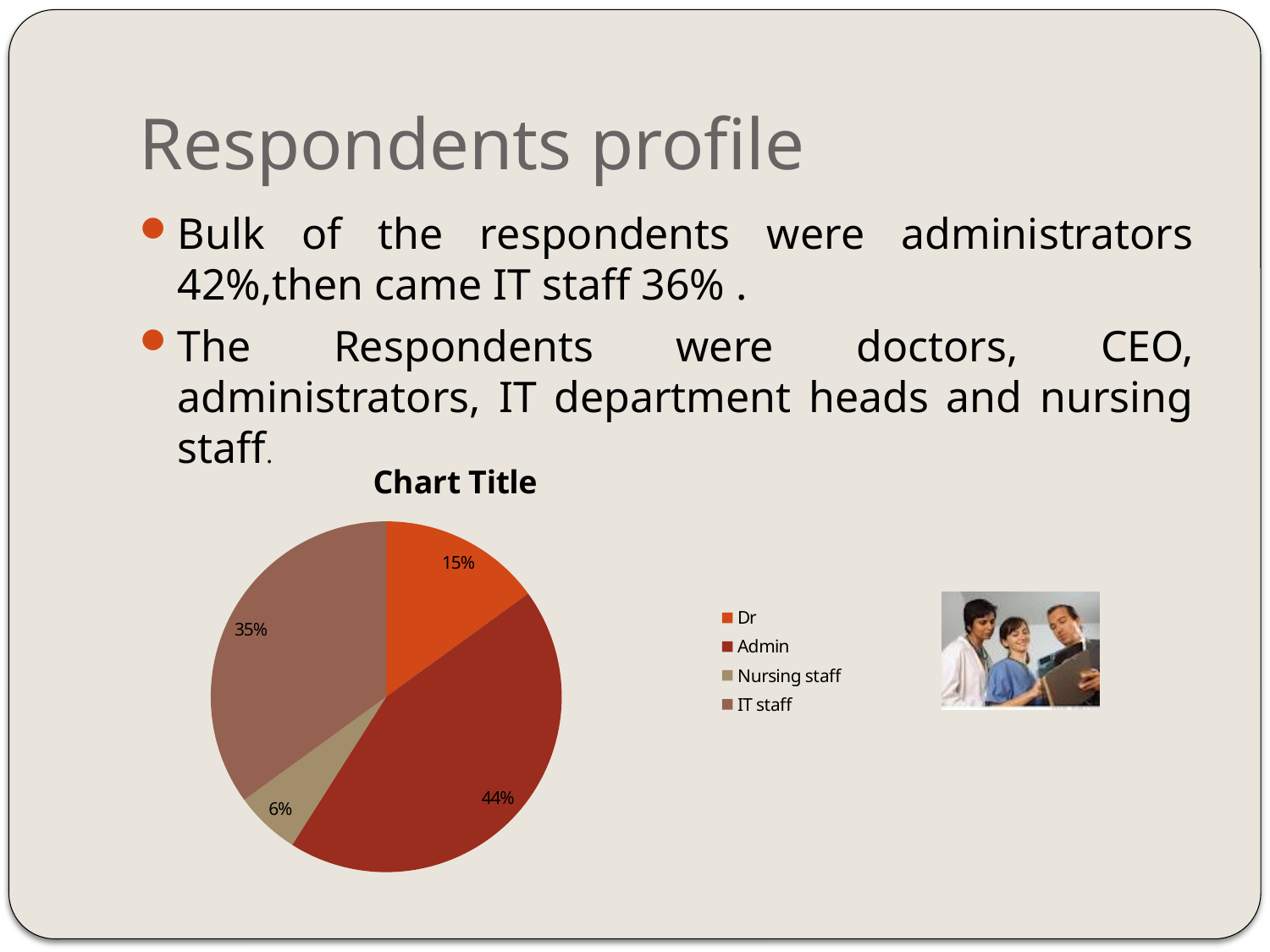
Which category has the smallest slice of the pie? Nursing staff What kind of chart is shown on the slide? pie chart What share of the pie does Admin have? 44% What is the title of the chart? Chart Title What share of the pie does Dr have? 15% Which category is shown in the bright orange colour in the legend? Dr What share of the pie does IT staff have? 35% Which is larger, the Dr slice or the Nursing staff slice? Dr What is the difference between the Admin share and the IT staff share? 9% Which category has the largest slice of the pie? Admin How many categories does the pie chart show? 4